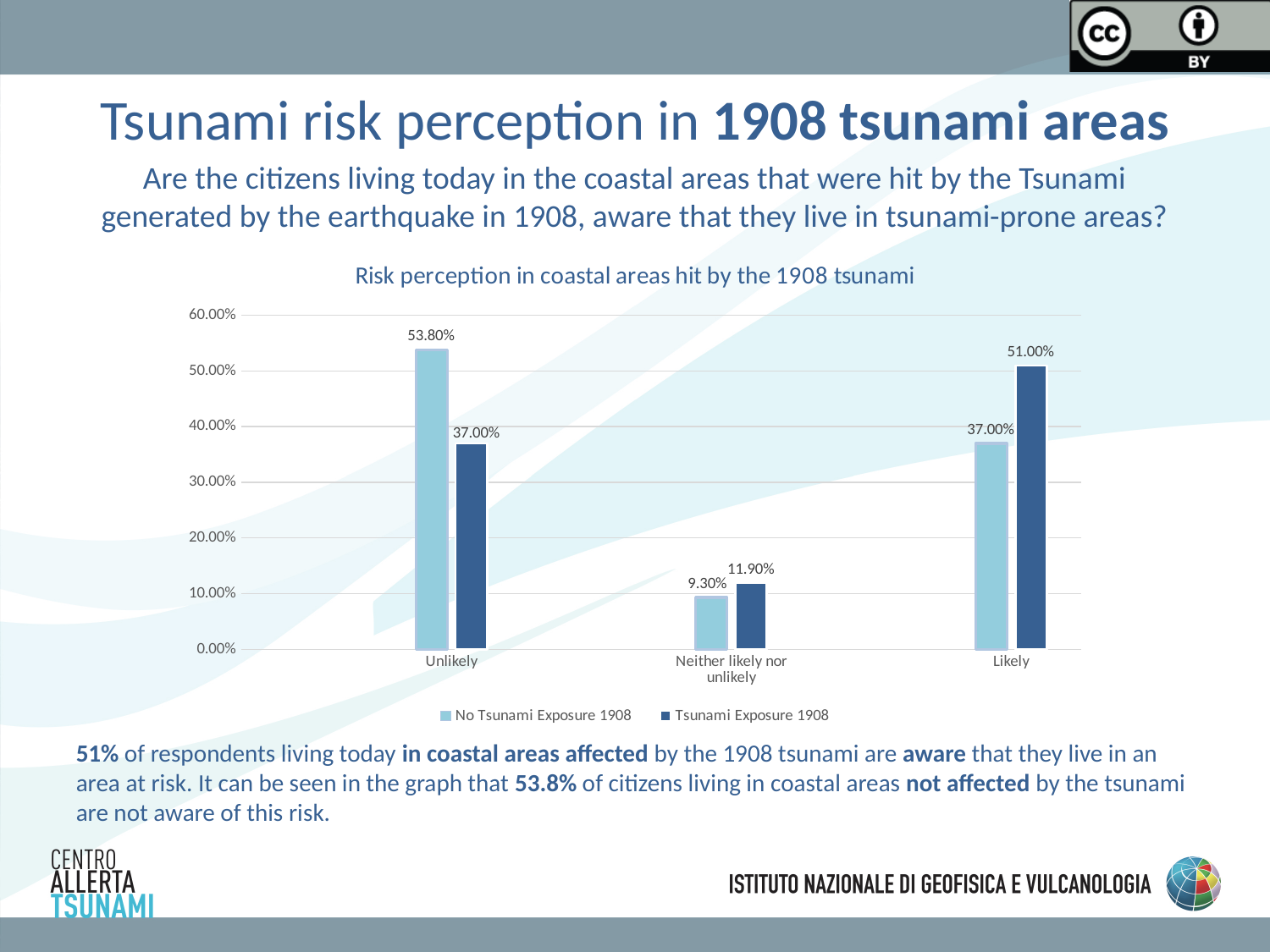
How many categories are shown on the x axis? 3 How many series does the legend list? 2 What is the value for 'Neither likely nor unlikely' in the 'No Tsunami Exposure 1908' series? 9.30% What kind of chart is shown on the slide? Bar chart What is the value for 'Unlikely' in the 'No Tsunami Exposure 1908' series? 53.80% What is the difference between the 'No Tsunami Exposure 1908' and 'Tsunami Exposure 1908' values for 'Unlikely'? 16.80% For 'Neither likely nor unlikely', which series has the larger value? Tsunami Exposure 1908 What is the value for 'Likely' in the 'Tsunami Exposure 1908' series? 51.00% Is the value for 'Likely' in the 'No Tsunami Exposure 1908' series greater or less than 40.00%? less Which category has the lowest value in the 'No Tsunami Exposure 1908' series? Neither likely nor unlikely What is the title of the chart? Risk perception in coastal areas hit by the 1908 tsunami Which category has the highest value in the 'Tsunami Exposure 1908' series? Likely